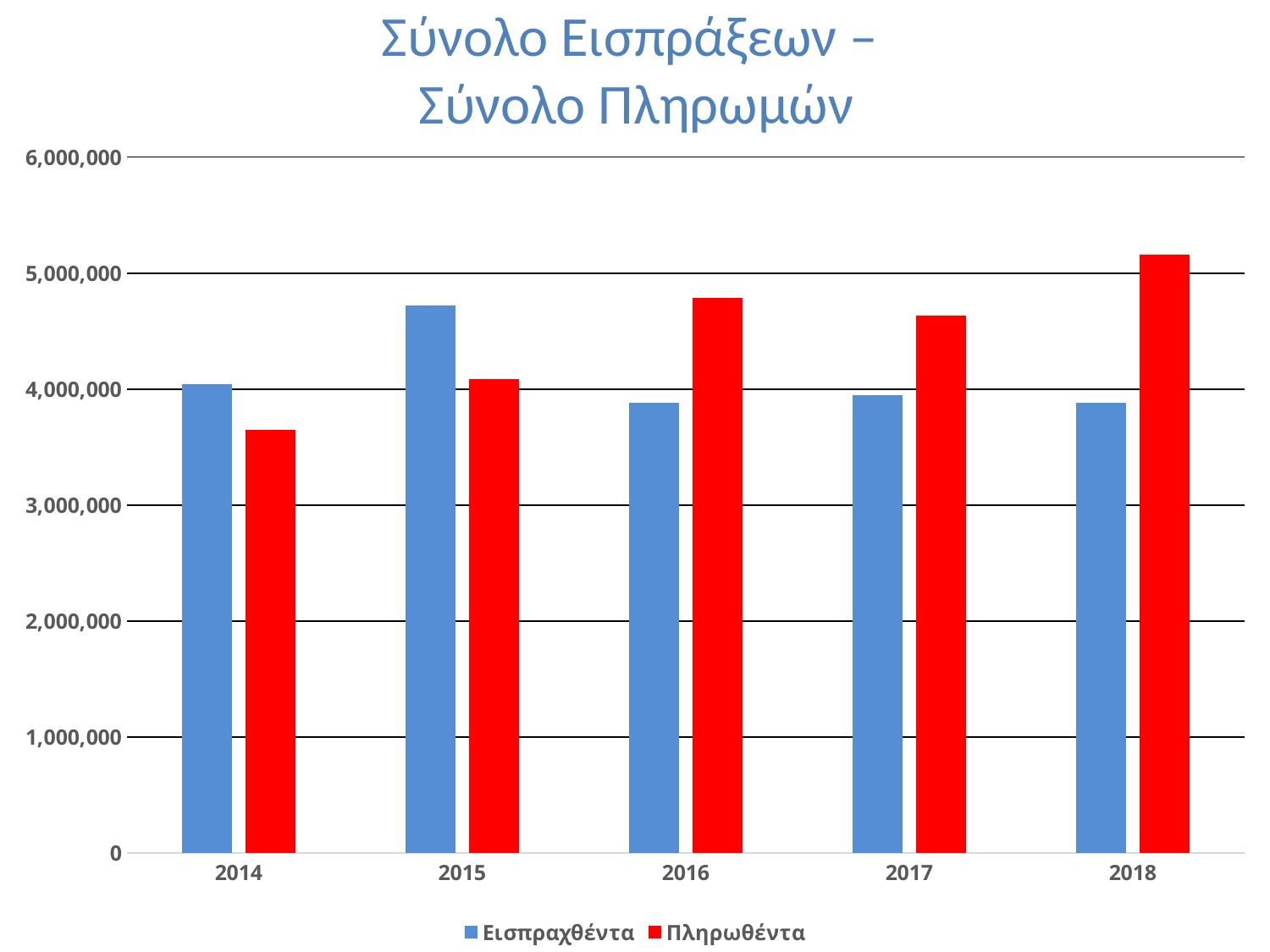
How many series does the legend list? 2 In which year is the value for Εισπραχθέντα highest? 2015 In which year is the value for Πληρωθέντα lowest? 2014 What kind of chart is shown on the slide? bar chart Is the value for Πληρωθέντα in 2018 greater or less than 5,000,000? greater In 2014, which is larger: Εισπραχθέντα or Πληρωθέντα? Εισπραχθέντα In which year is the value for Πληρωθέντα highest? 2018 What colour are the bars for Πληρωθέντα? red In 2016, which is larger: Εισπραχθέντα or Πληρωθέντα? Πληρωθέντα Is the value for Εισπραχθέντα in 2015 greater or less than 4,000,000? greater Is the value for Πληρωθέντα in 2014 greater or less than 4,000,000? less How many years are shown on the x axis? 5